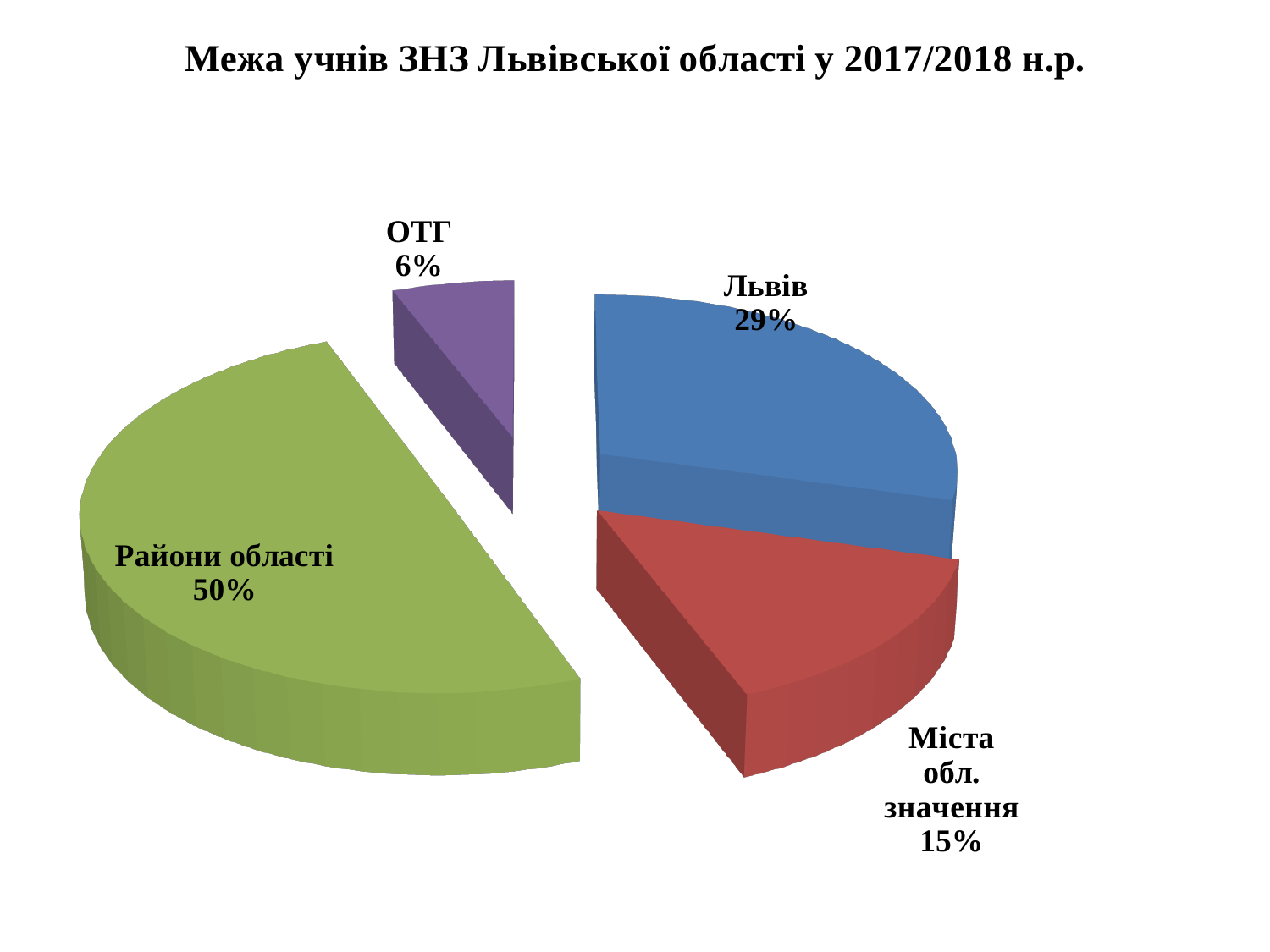
What is the title of the chart? Межа учнів ЗНЗ Львівської області у 2017/2018 н.р. What share of the pie does Райони області have? 50% What kind of chart is shown on the slide? Pie chart Which is larger, the share for Львів or the share for Міста обл. значення? Львів Which category has the largest share of the pie? Райони області What share of the pie does Міста обл. значення have? 15% What is the difference in percentage points between Райони області and ОТГ? 44 What share of the pie does Львів have? 29% Which category has the smallest share of the pie? ОТГ What is the difference in percentage points between Львів and Міста обл. значення? 14 How many categories (slices) does the pie chart have? 4